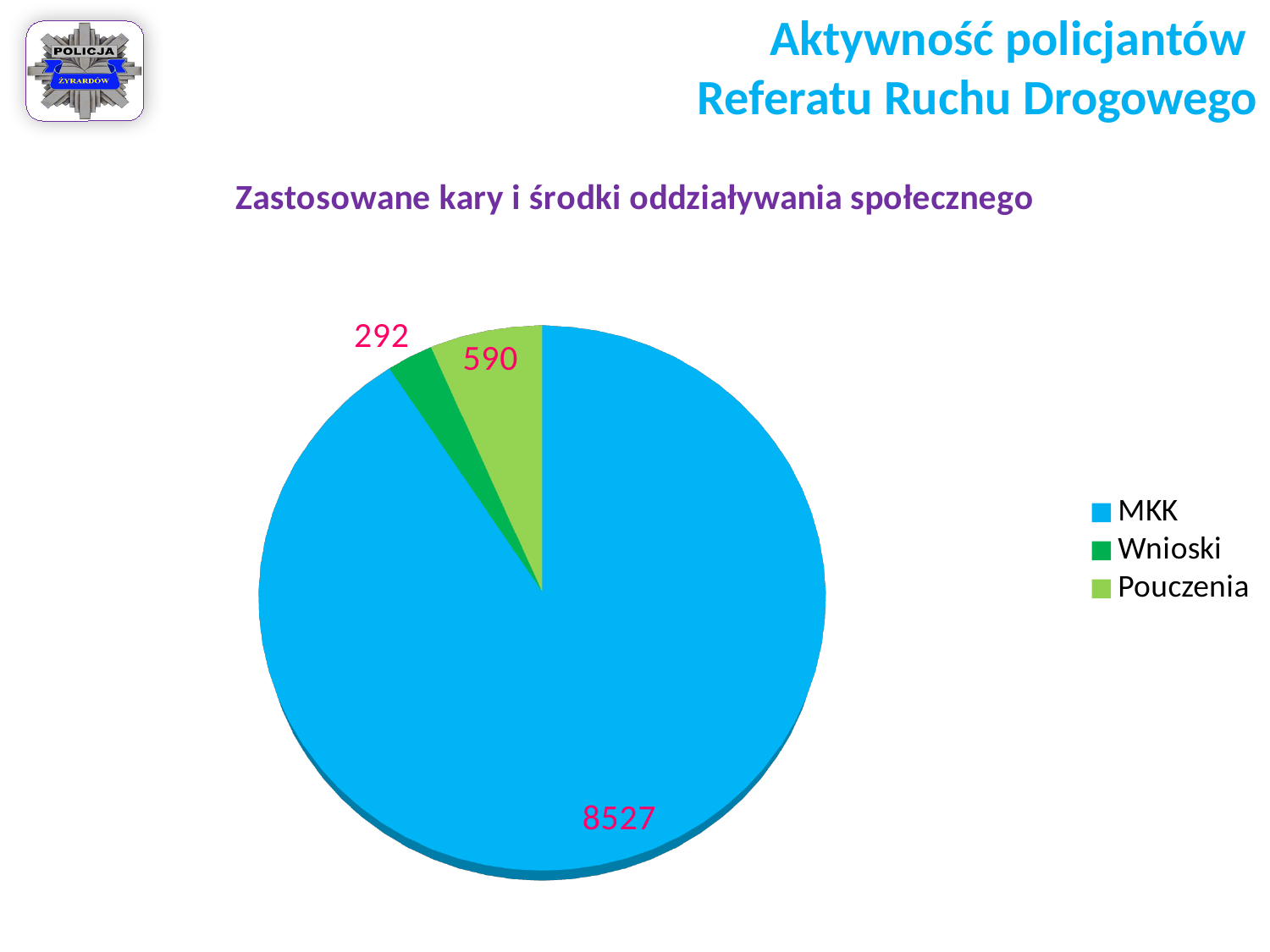
How many categories does the pie chart show? 3 What type of chart is shown on the slide? pie chart Which category has the largest slice in the pie chart? MKK What is the value for MKK in the pie chart? 8527 Which category has the smallest slice in the pie chart? Wnioski What is the value for Pouczenia in the pie chart? 590 What is the difference between the values for MKK and Pouczenia? 7937 How many entries does the legend list? 3 What is the value for Wnioski in the pie chart? 292 What is the difference between the values for Pouczenia and Wnioski? 298 Which is larger, the value for Pouczenia or the value for Wnioski? Pouczenia What is the title of the pie chart? Zastosowane kary i środki oddziaływania społecznego